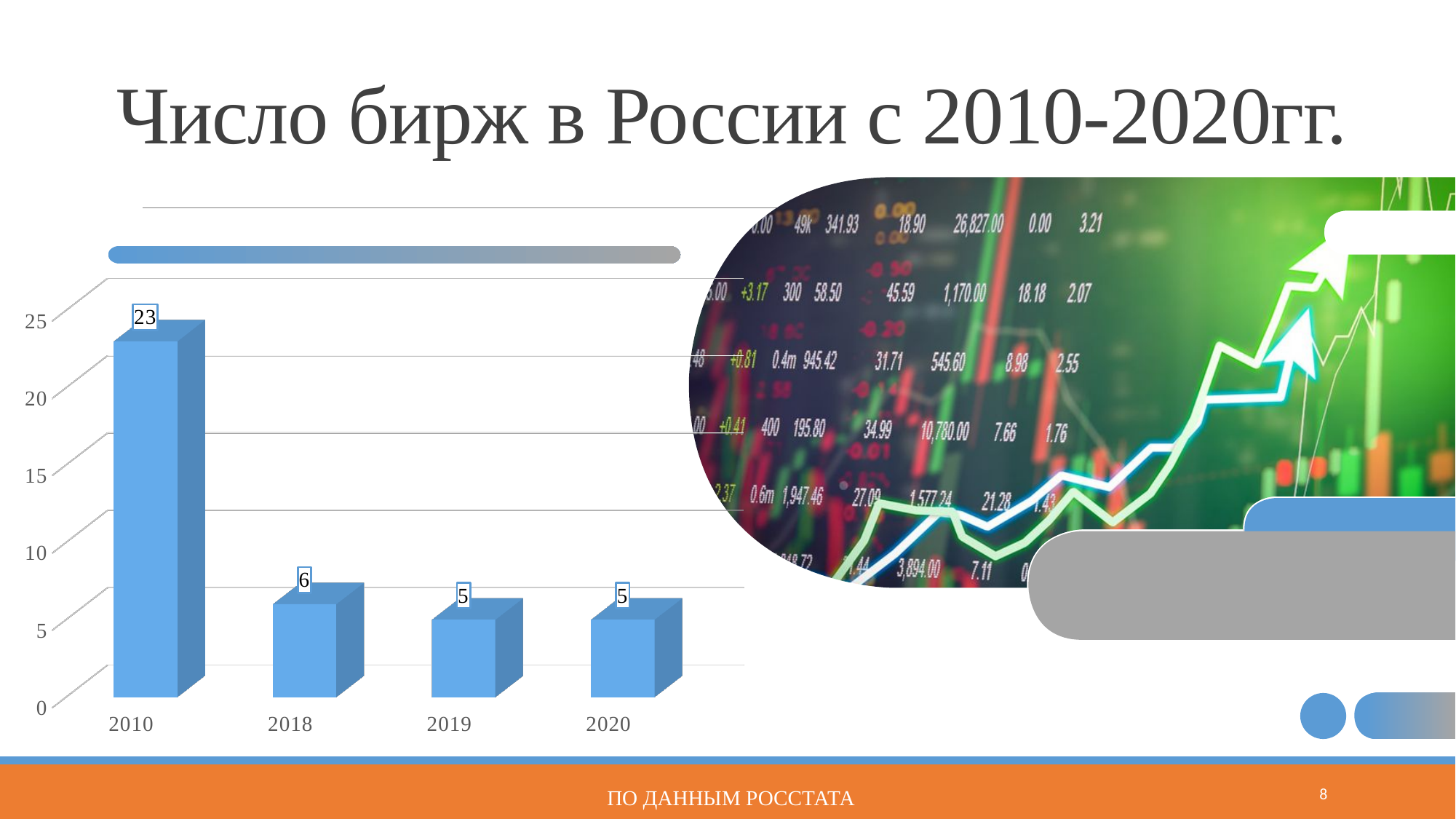
What is the value shown for 2018? 6 What is the number of exchanges in 2010? 23 How many years are shown on the x axis? 4 What is the value shown for 2019? 5 What is the value shown for 2020? 5 Do the values rise or fall from 2010 to 2020? fall Which is larger, the value for 2010 or the value for 2020? 2010 What is the difference between the values for 2010 and 2018? 17 What kind of chart is shown on the slide? bar chart Is the value for 2010 greater or less than 20? greater Which year has the highest value? 2010 What is the difference between the values for 2018 and 2019? 1